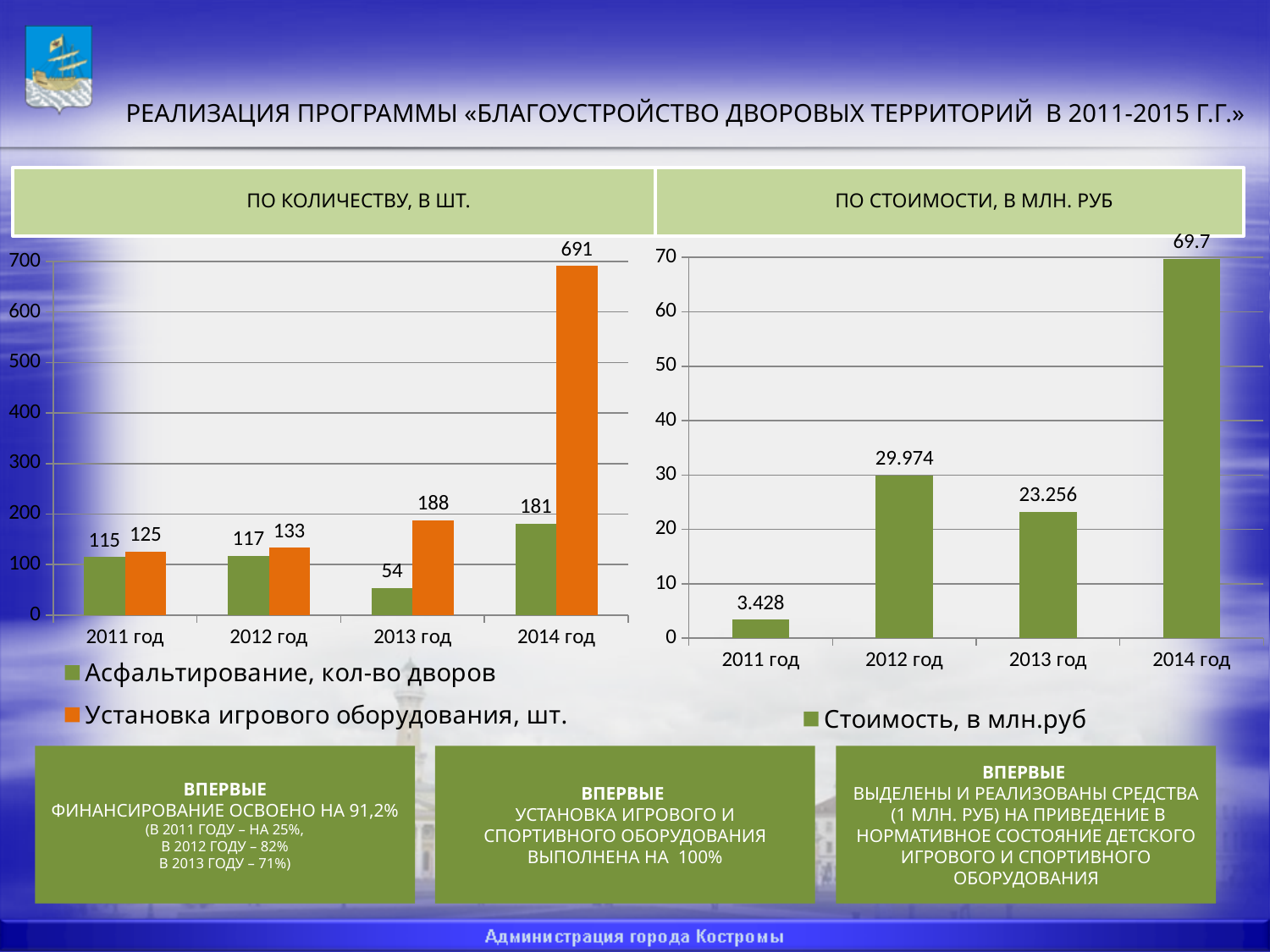
In the chart "ПО КОЛИЧЕСТВУ, В ШТ.", which year has the lowest value for Асфальтирование, кол-во дворов? 2013 год What kind of chart is the chart "ПО СТОИМОСТИ, В МЛН. РУБ"? bar chart In the chart "ПО СТОИМОСТИ, В МЛН. РУБ", what is the value for 2012 год? 29.974 In the chart "ПО КОЛИЧЕСТВУ, В ШТ.", how many series does the legend list? 2 In the chart "ПО СТОИМОСТИ, В МЛН. РУБ", how many years are shown on the x axis? 4 In the chart "ПО КОЛИЧЕСТВУ, В ШТ.", what is the value for Асфальтирование, кол-во дворов in 2013 год? 54 In the chart "ПО СТОИМОСТИ, В МЛН. РУБ", what is the difference between the values for 2012 год and 2013 год? 6.718 In the chart "ПО КОЛИЧЕСТВУ, В ШТ.", which is larger in 2012 год: Асфальтирование, кол-во дворов or Установка игрового оборудования, шт.? Установка игрового оборудования, шт. In the chart "ПО СТОИМОСТИ, В МЛН. РУБ", which year has the lowest value? 2011 год In the chart "ПО СТОИМОСТИ, В МЛН. РУБ", which year has the highest value? 2014 год In the chart "ПО КОЛИЧЕСТВУ, В ШТ.", what is the difference between Установка игрового оборудования, шт. and Асфальтирование, кол-во дворов in 2014 год? 510 In the chart "ПО КОЛИЧЕСТВУ, В ШТ.", what is the value for Установка игрового оборудования, шт. in 2014 год? 691